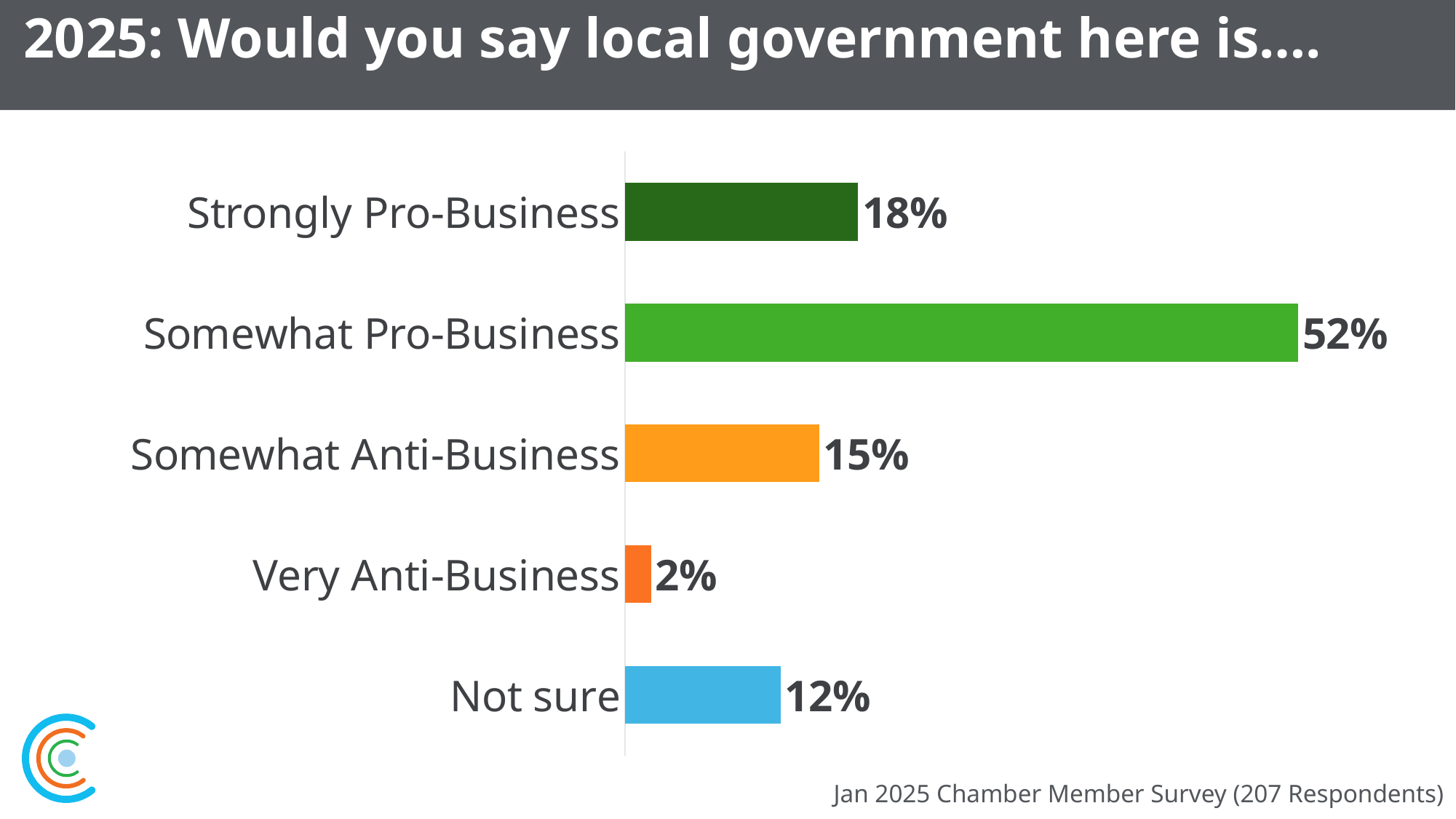
What percentage of respondents answered Not sure? 12% Which response category has the highest percentage? Somewhat Pro-Business Which response category has the lowest percentage? Very Anti-Business What is the difference in percentage points between Somewhat Anti-Business and Very Anti-Business? 13 What percentage of respondents said local government is Very Anti-Business? 2% What percentage of respondents said local government is Strongly Pro-Business? 18% Which is larger, the percentage for Strongly Pro-Business or for Somewhat Anti-Business? Strongly Pro-Business How many response categories are shown in the chart? 5 What percentage of respondents said local government is Somewhat Pro-Business? 52% According to the source note, how many respondents took part in the survey? 207 What type of chart is shown on the slide? Bar chart What is the difference in percentage points between Somewhat Pro-Business and Strongly Pro-Business? 34